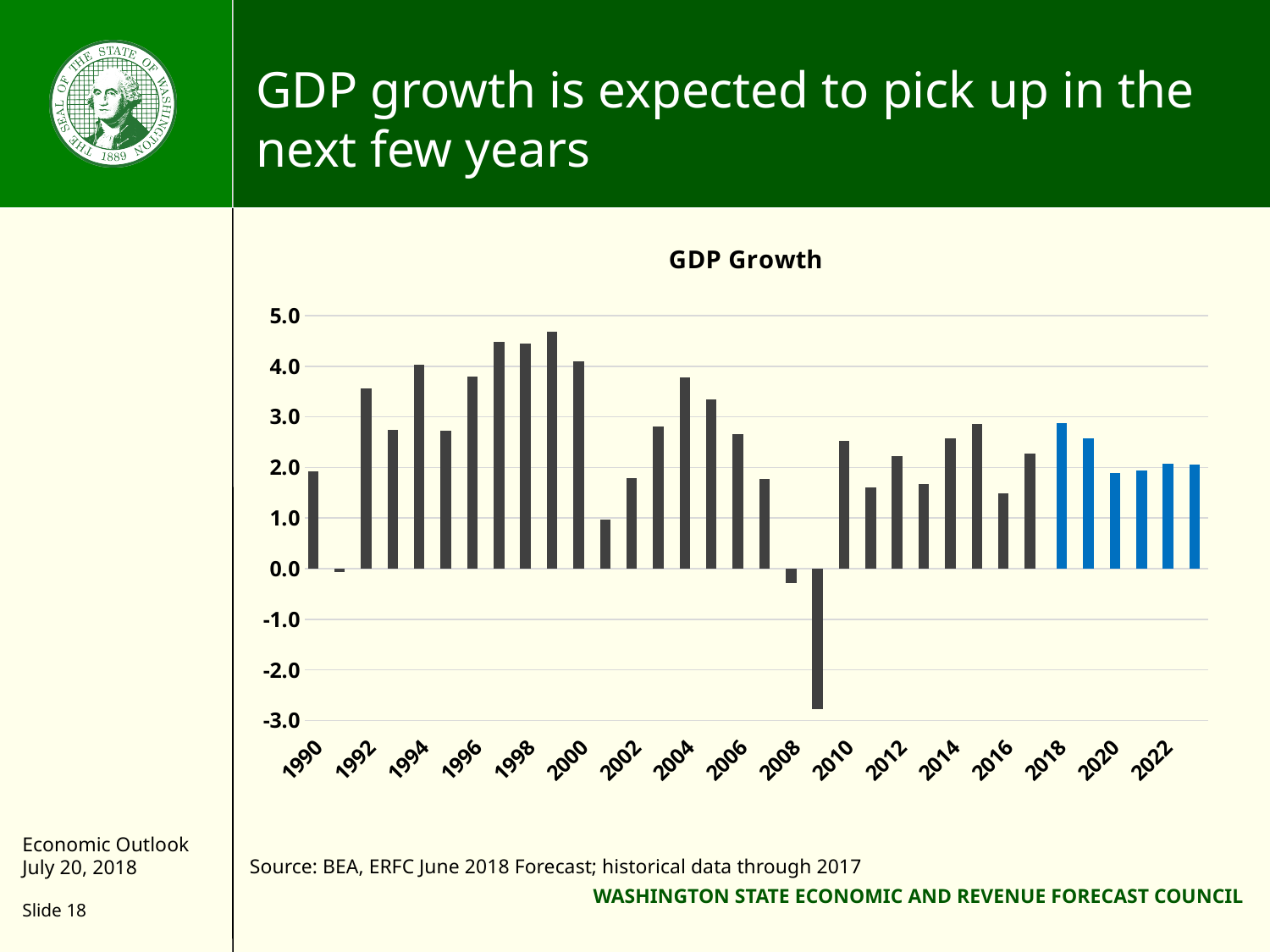
Which year has the highest GDP growth in the chart? 1999 Is the GDP growth value for 2004 greater or less than 3.0? greater Is the GDP growth value for 2016 greater or less than 2.0? less Do the GDP growth values rise or fall from 2001 to 2004? rise Is the GDP growth value for 2009 greater or less than -2.0? less Which year has higher GDP growth, 1992 or 2012? 1992 Which year has higher GDP growth, 2010 or 2011? 2010 What kind of chart is shown on the slide? bar chart How many years are labeled on the x axis? 17 Which year has the lowest GDP growth in the chart? 2009 What is the title of the chart? GDP Growth